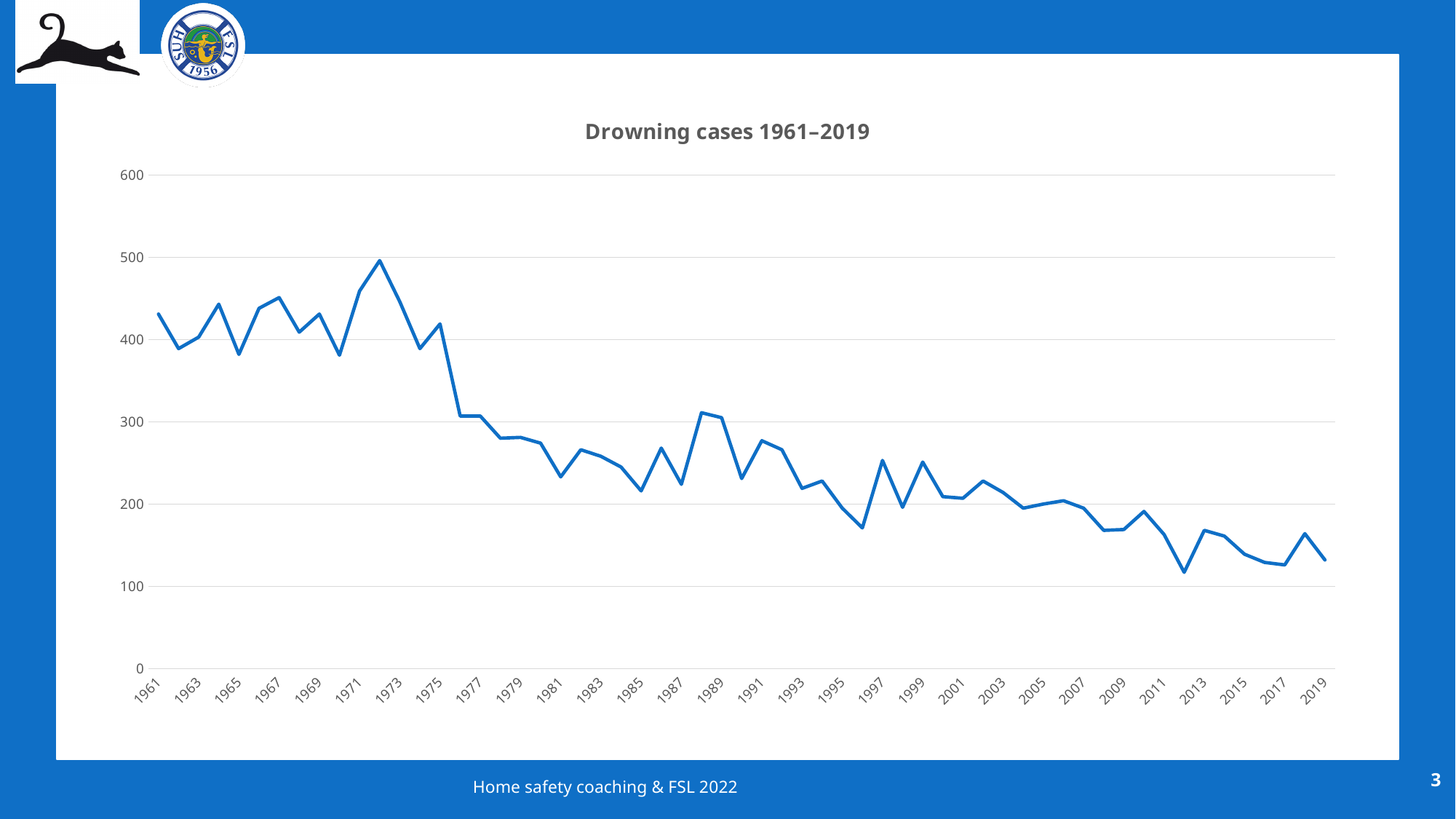
Which year has more drowning cases, 1961 or 2019? 1961 What is the title of the chart? Drowning cases 1961–2019 What kind of chart is shown on the slide? line chart Overall, do the drowning cases rise or fall from 1961 to 2019? fall Is the value for 1985 greater or less than 200? greater Is the value for 1965 greater or less than 400? less Is the value for 2019 greater or less than 200? less Which year has the highest number of drowning cases? 1972